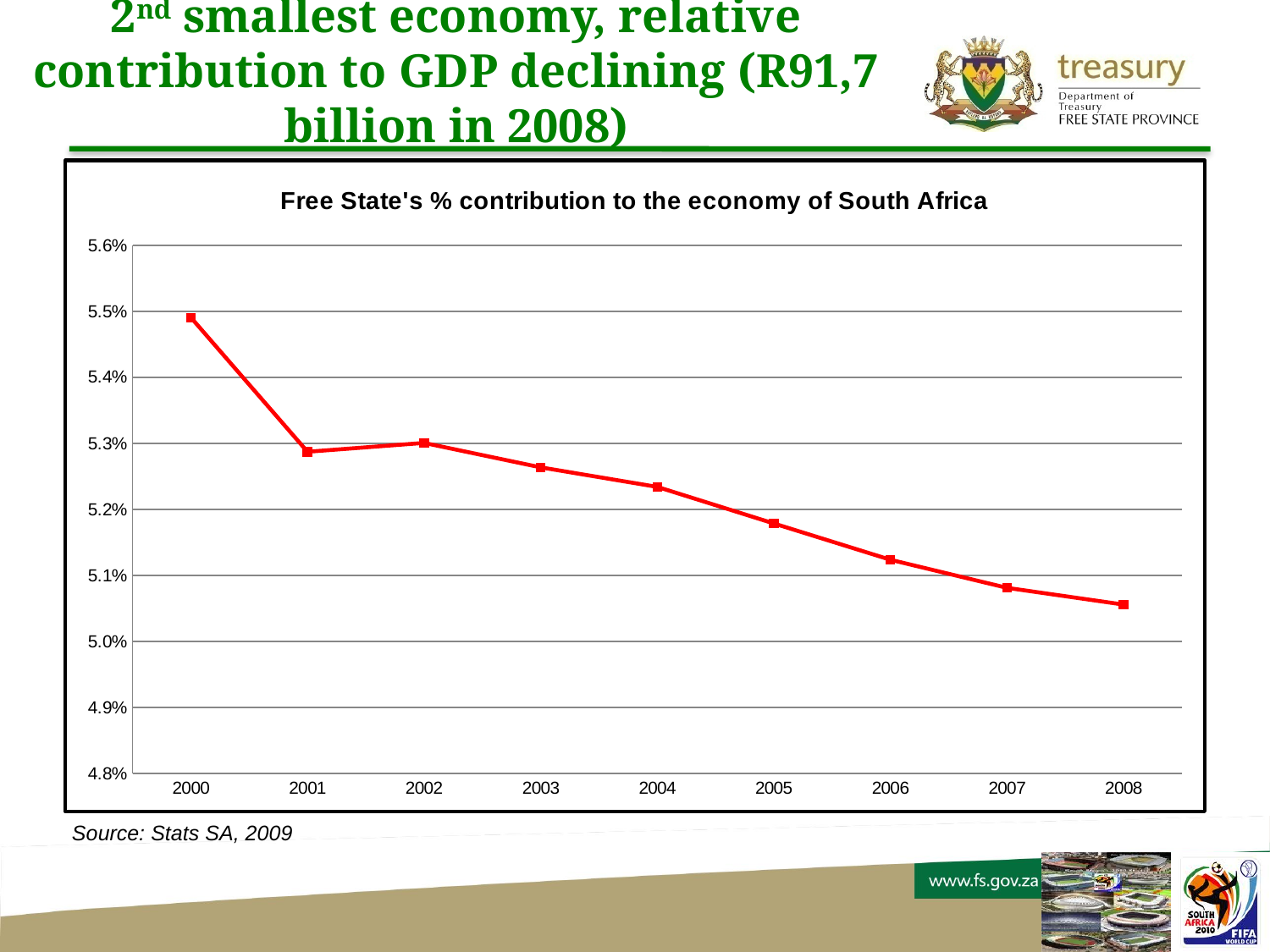
Do the values in the chart generally rise or fall from 2000 to 2008? fall What is the title of the chart? Free State's % contribution to the economy of South Africa What kind of chart is shown on the slide? line chart Is the value for 2005 greater or less than 5.2%? less Which year has the highest value in the chart? 2000 Is the value for 2003 greater or less than 5.3%? less Which year has the lowest value in the chart? 2008 What colour is the line in the chart? red Is the value for 2000 greater or less than 5.4%? greater How many years are plotted on the x axis of the chart? 9 Which year has the larger value, 2000 or 2004? 2000